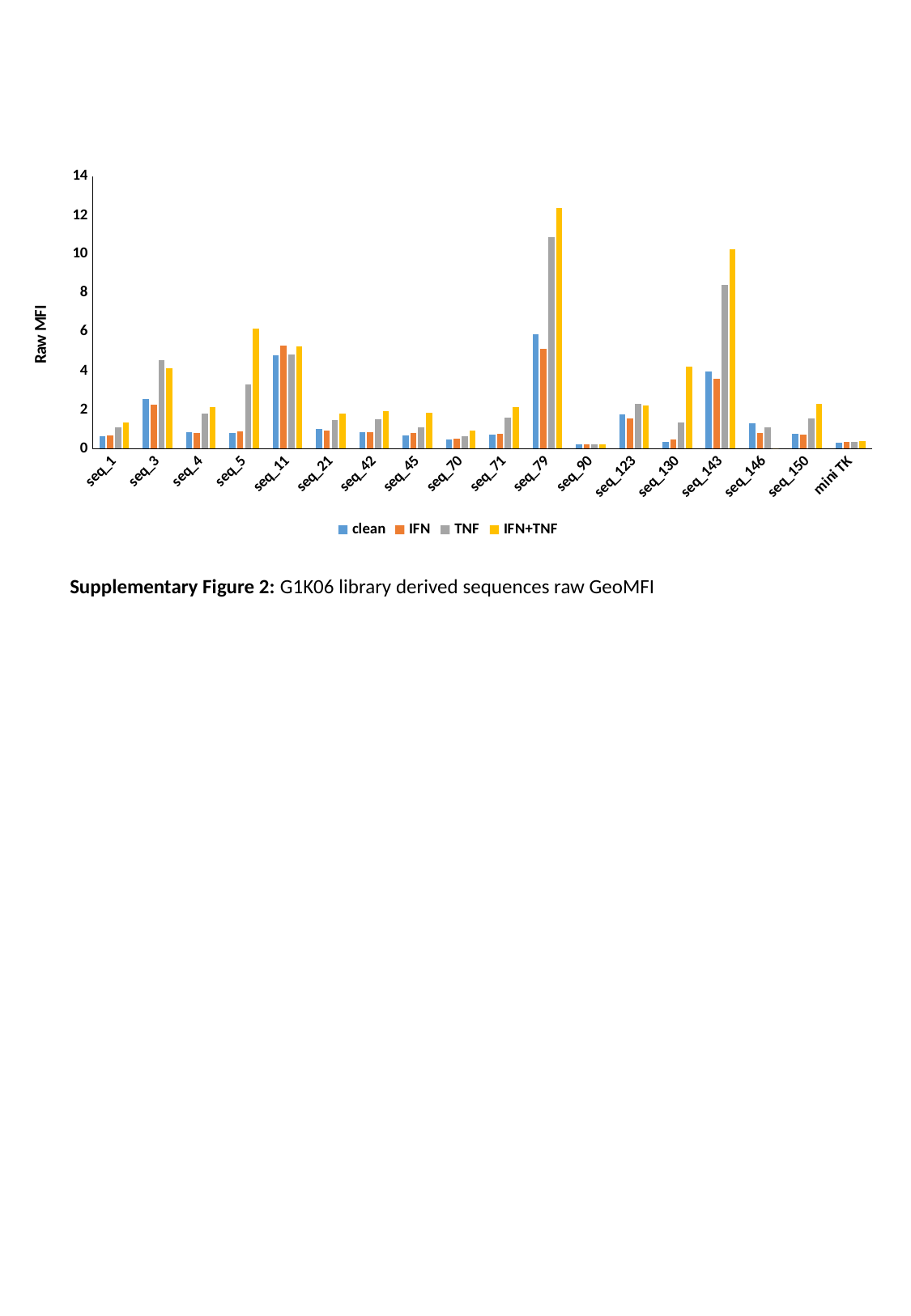
Which category has the highest TNF value? seq_79 What kind of chart is shown on the slide? bar chart What is the label on the y axis? Raw MFI Is the TNF value for seq_143 greater or less than 6? greater Is the IFN+TNF value for seq_5 greater or less than 4? greater How many sequence categories are shown on the x axis? 18 Which is larger, the IFN+TNF value for seq_79 or the IFN+TNF value for seq_143? seq_79 How many series does the legend list? 4 Is the IFN+TNF value for seq_79 greater or less than 10? greater Which is larger, the clean value for seq_11 or the clean value for seq_3? seq_11 Which category has the highest IFN+TNF value? seq_79